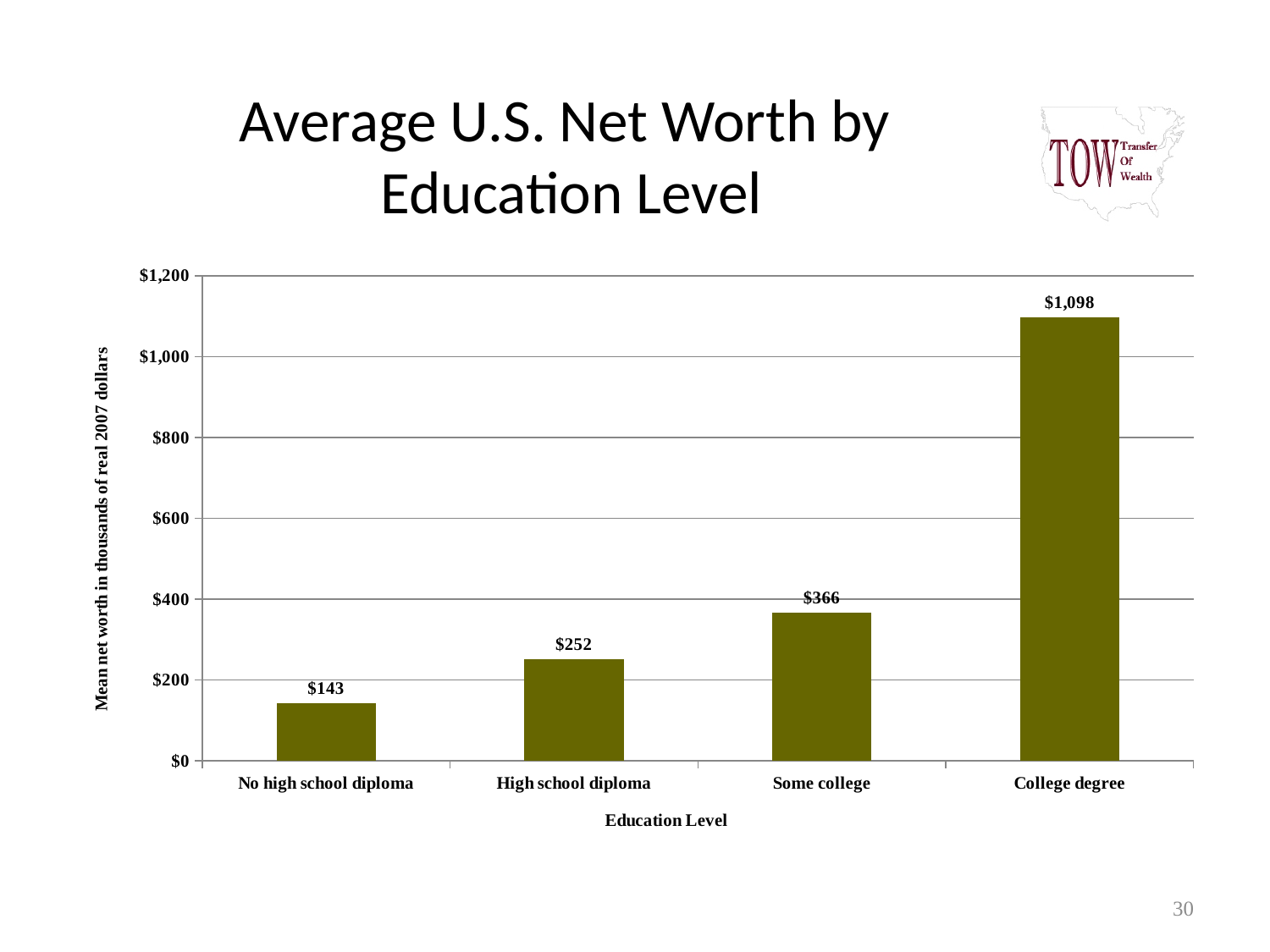
What kind of chart is shown on the slide? Bar chart Do the values rise or fall moving from left to right along the x axis? Rise Which education level has the highest mean net worth? College degree What is the mean net worth for the No high school diploma category? $143 What is the value shown for Some college? $366 Is the value for College degree greater or less than $1,000? greater What is the difference between the values for College degree and Some college? $732 How many education level categories are shown on the chart? 4 What is the mean net worth for the College degree category? $1,098 Which education level has the lowest mean net worth? No high school diploma Which is larger, the value for High school diploma or the value for Some college? Some college What is the difference between the values for High school diploma and No high school diploma? $109